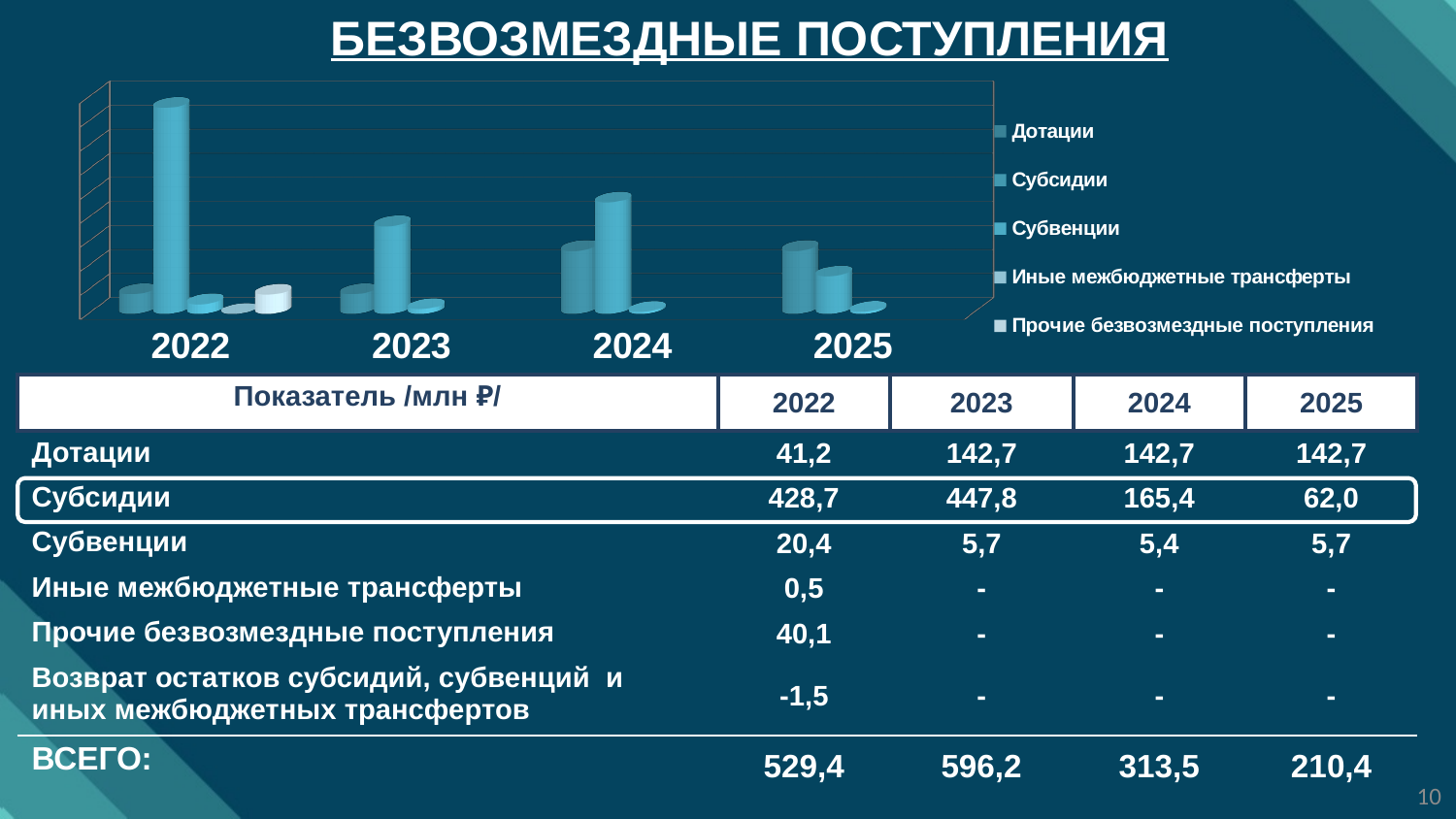
What is the title of the slide's chart? БЕЗВОЗМЕЗДНЫЕ ПОСТУПЛЕНИЯ What is the value of Дотации for 2024 (млн ₽)? 142,7 What kind of chart is shown on the slide? Bar chart In which year is the value of Субсидии the lowest? 2025 Which is larger in 2025: Дотации or Субсидии? Дотации What is the value of Субсидии for 2022 (млн ₽)? 428,7 What is the difference between Субсидии in 2022 and Субсидии in 2025? 366,7 How many series does the chart legend list? 5 What is the value of Субвенции for 2022 (млн ₽)? 20,4 Do the values of Субсидии rise or fall from 2023 to 2025? Fall How many years (categories) are shown along the x axis of the chart? 4